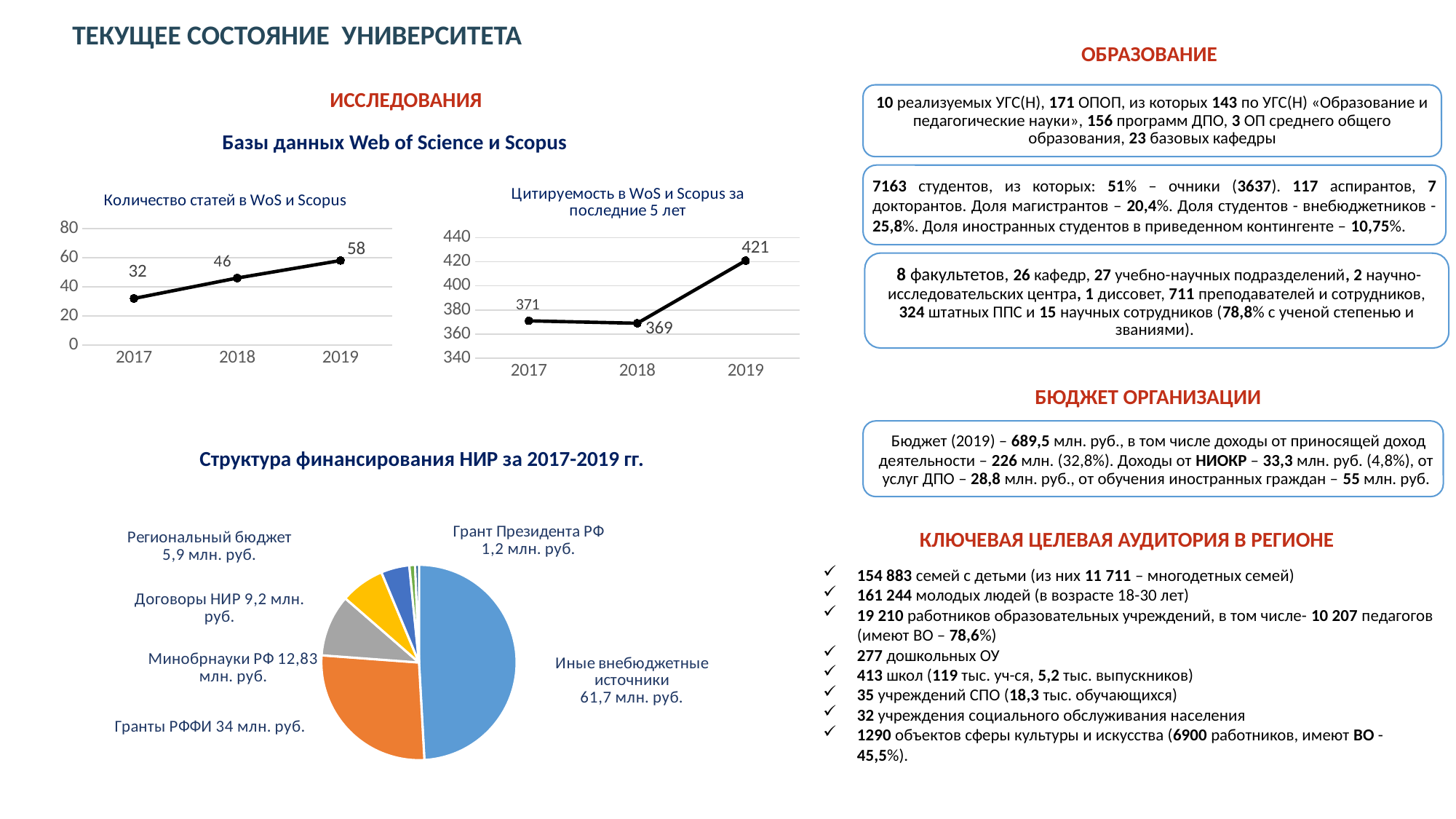
In the chart 'Цитируемость в WoS и Scopus за последние 5 лет', what is the difference between the 2019 and 2017 values? 50 What kind of chart is 'Структура финансирования НИР за 2017-2019 гг.'? pie chart In the chart 'Цитируемость в WoS и Scopus за последние 5 лет', which year has the lowest value? 2018 In the pie chart 'Структура финансирования НИР за 2017-2019 гг.', which source has the largest value? Иные внебюджетные источники In the pie chart 'Структура финансирования НИР за 2017-2019 гг.', what is the value for Гранты РФФИ? 34 млн. руб. In the chart 'Цитируемость в WoS и Scopus за последние 5 лет', which year has the highest value? 2019 In the chart 'Количество статей в WoS и Scopus', by how much did the value increase from 2017 to 2019? 26 In the chart 'Количество статей в WoS и Scopus', what is the value for 2019? 58 In the chart 'Количество статей в WoS и Scopus', do the values rise or fall from 2017 to 2019? rise How many slices does the pie chart 'Структура финансирования НИР за 2017-2019 гг.' have? 7 In the chart 'Цитируемость в WoS и Scopus за последние 5 лет', what is the value for 2018? 369